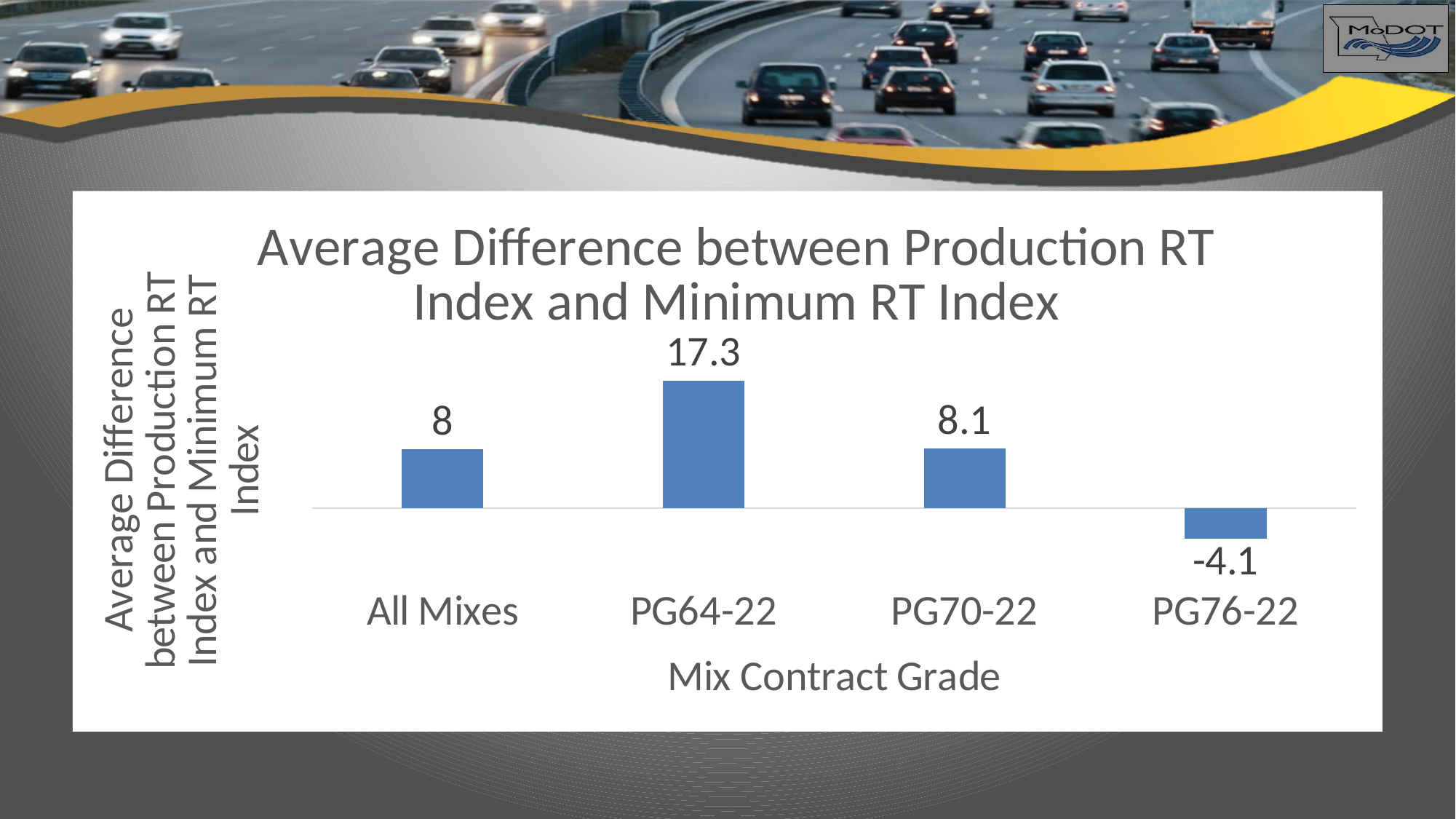
What is the x-axis title of the chart? Mix Contract Grade What is the value for PG64-22? 17.3 What is the difference between the values for PG70-22 and PG76-22? 12.2 What kind of chart is shown on the slide? Bar chart Which mix contract grade has the lowest value? PG76-22 Which mix contract grade has the highest value? PG64-22 What is the value for All Mixes? 8 What is the value for PG76-22? -4.1 Which is larger, the value for PG64-22 or the value for All Mixes? PG64-22 What is the value for PG70-22? 8.1 What is the difference between the values for PG64-22 and PG70-22? 9.2 How many mix contract grade categories are shown on the chart? 4